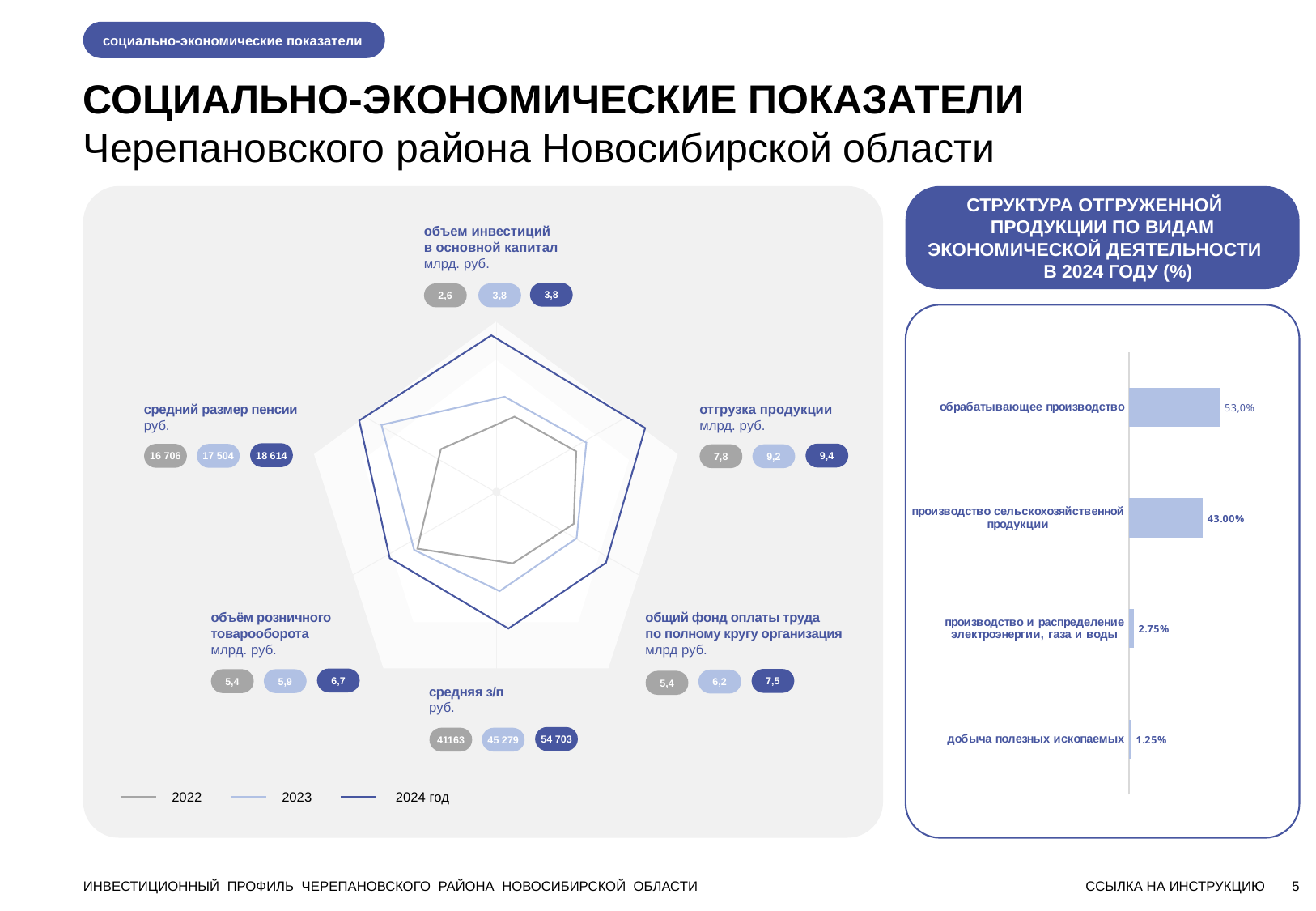
In the bar chart on the right, what is the value for добыча полезных ископаемых? 1.25% In the bar chart on the right, how many categories are shown? 4 In the radar chart on the left, what is the value of отгрузка продукции for 2024? 9,4 In the radar chart on the left, what is the difference between средний размер пенсии in 2024 and in 2022? 1 908 In the bar chart on the right, what is the difference between the values for обрабатывающее производство and производство сельскохозяйственной продукции? 10 percentage points In the bar chart on the right, which category has the highest value? обрабатывающее производство In the bar chart on the right, which category has the lowest value? добыча полезных ископаемых In the radar chart on the left, how many series does the legend list? 3 What kind of chart is shown on the right side of the slide? bar chart In the radar chart on the left, which is larger: общий фонд оплаты труда in 2023 or in 2024? 2024 In the bar chart on the right, what is the value for обрабатывающее производство? 53,0% In the radar chart on the left, what is the value of средняя з/п for 2022? 41163